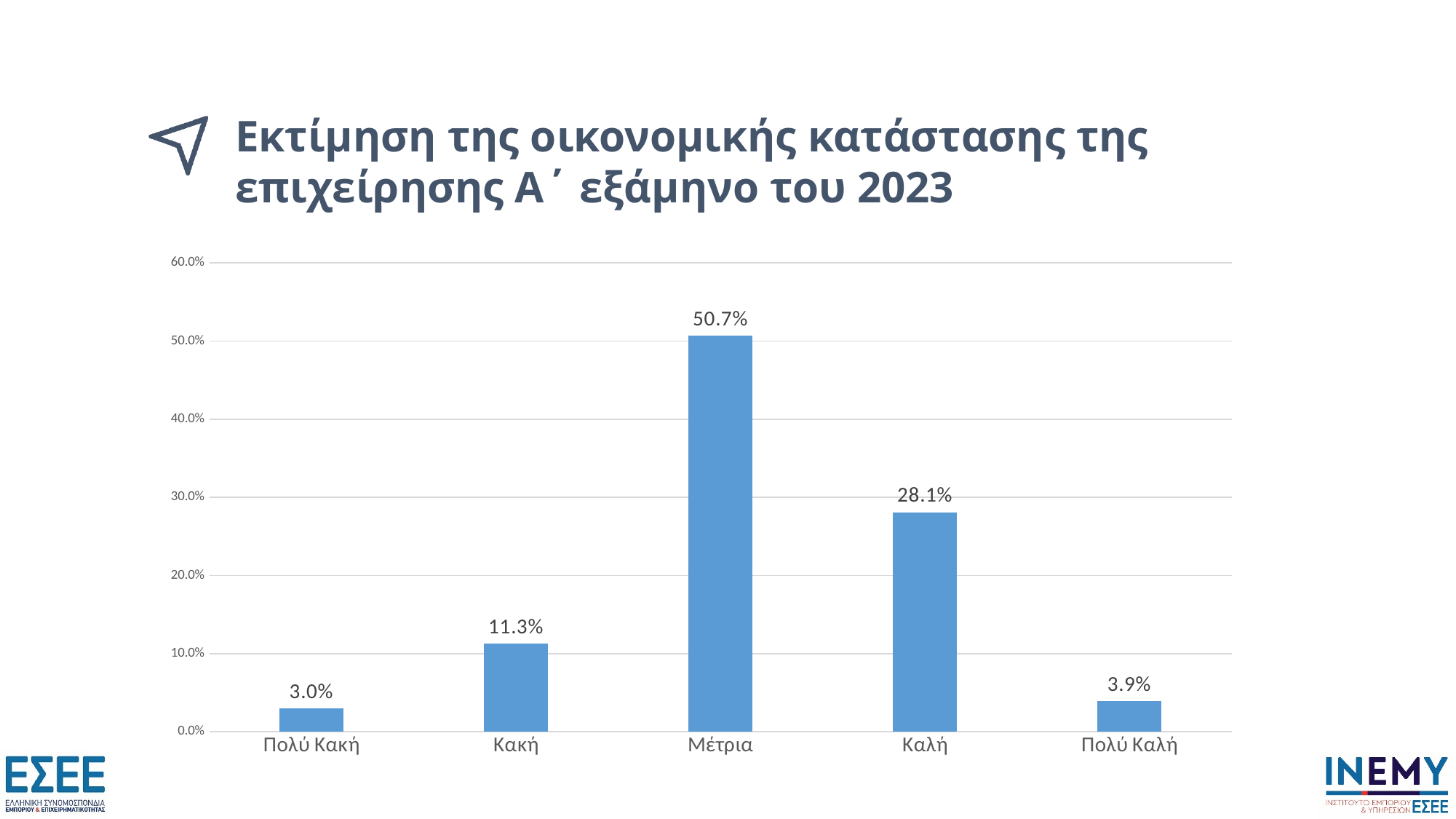
Which category has the lowest value? Πολύ Κακή What is the value for Μέτρια? 50.7% What is the difference between the values for Μέτρια and Καλή? 22.6% Which is larger, the value for Κακή or the value for Πολύ Καλή? Κακή How many categories are shown on the x axis? 5 Is the value for Καλή greater or less than 30.0%? less What is the title of the chart on the slide? Εκτίμηση της οικονομικής κατάστασης της επιχείρησης Α΄ εξάμηνο του 2023 What is the value for Πολύ Καλή? 3.9% What is the value for Πολύ Κακή? 3.0% What is the value for Καλή? 28.1% What kind of chart is shown on the slide? bar chart Which category has the highest value? Μέτρια